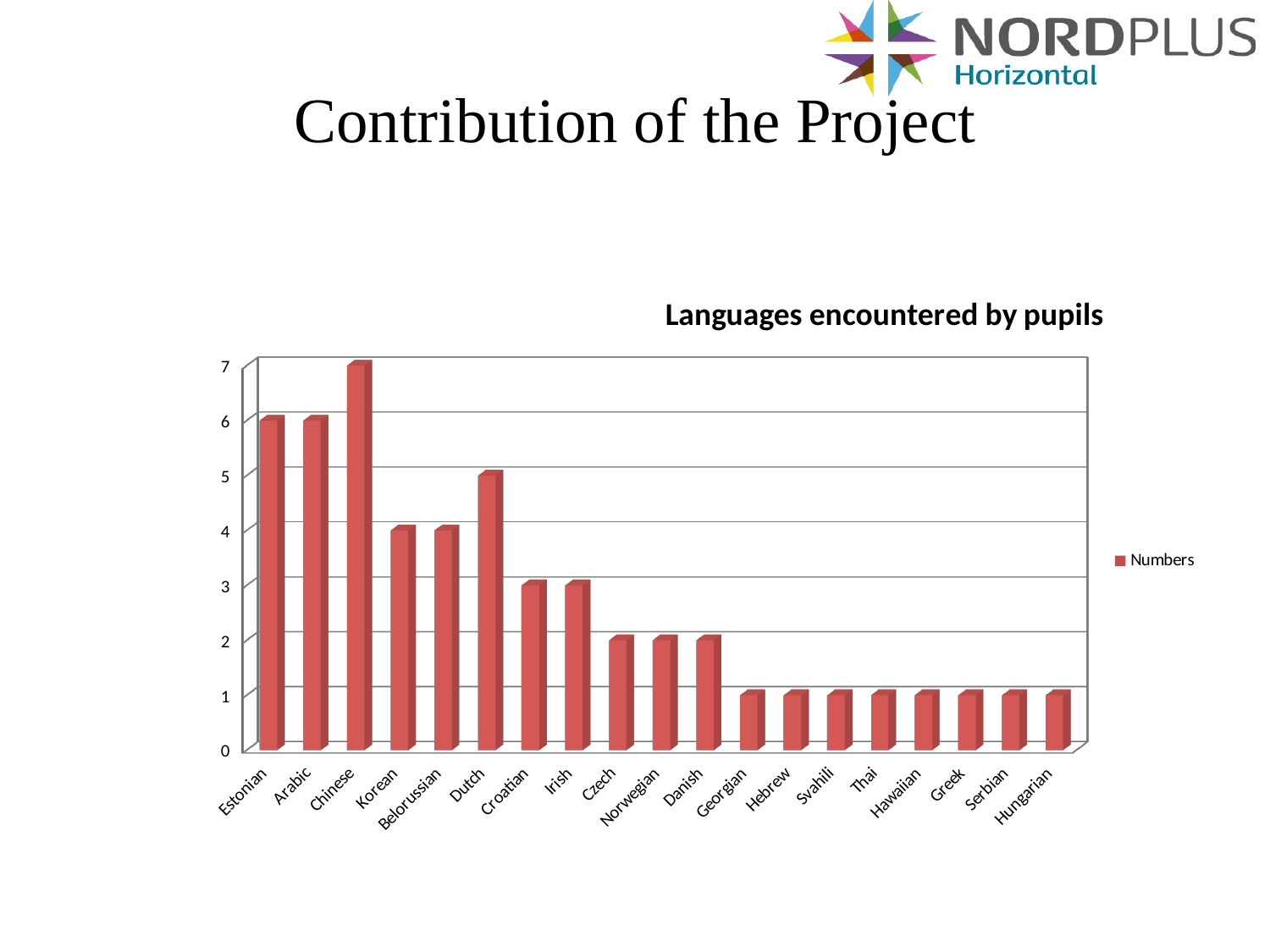
How many series does the legend list? 1 What is the value for Chinese? 7 How many languages are shown on the x axis? 19 What type of chart is shown on the slide? Bar chart What is the difference between the values for Chinese and Dutch? 2 Which language has the highest value? Chinese What is the title of the chart? Languages encountered by pupils What is the value for Croatian? 3 Which has a larger value, Dutch or Korean? Dutch Do the values generally rise or fall from left to right along the x axis? Fall Is the value for Estonian greater or less than 5? greater What is the value for Dutch? 5